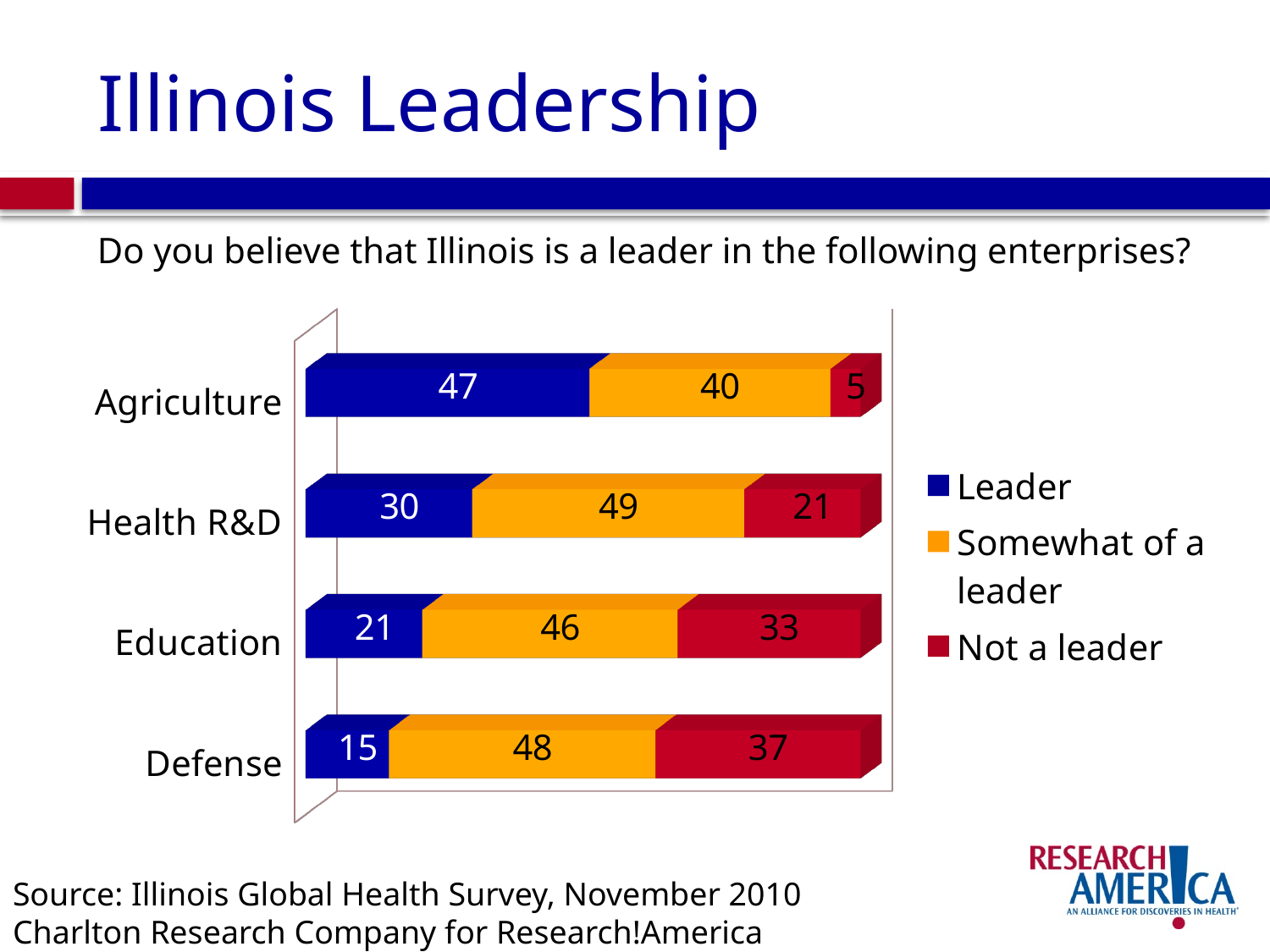
What kind of chart is shown on the slide? Stacked bar chart Which category has the highest "Leader" value? Agriculture How many series does the legend list? 3 Which is larger: the "Leader" value for Health R&D or the "Leader" value for Education? Health R&D Which legend entry is shown in red? Not a leader What is the total of the stacked bar for Defense? 100 What is the "Leader" value for Agriculture? 47 Which category has the lowest "Not a leader" value? Agriculture How many categories are shown on the chart? 4 What is the difference between the "Not a leader" values for Education and Health R&D? 12 What is the "Not a leader" value for Defense? 37 What is the "Somewhat of a leader" value for Health R&D? 49